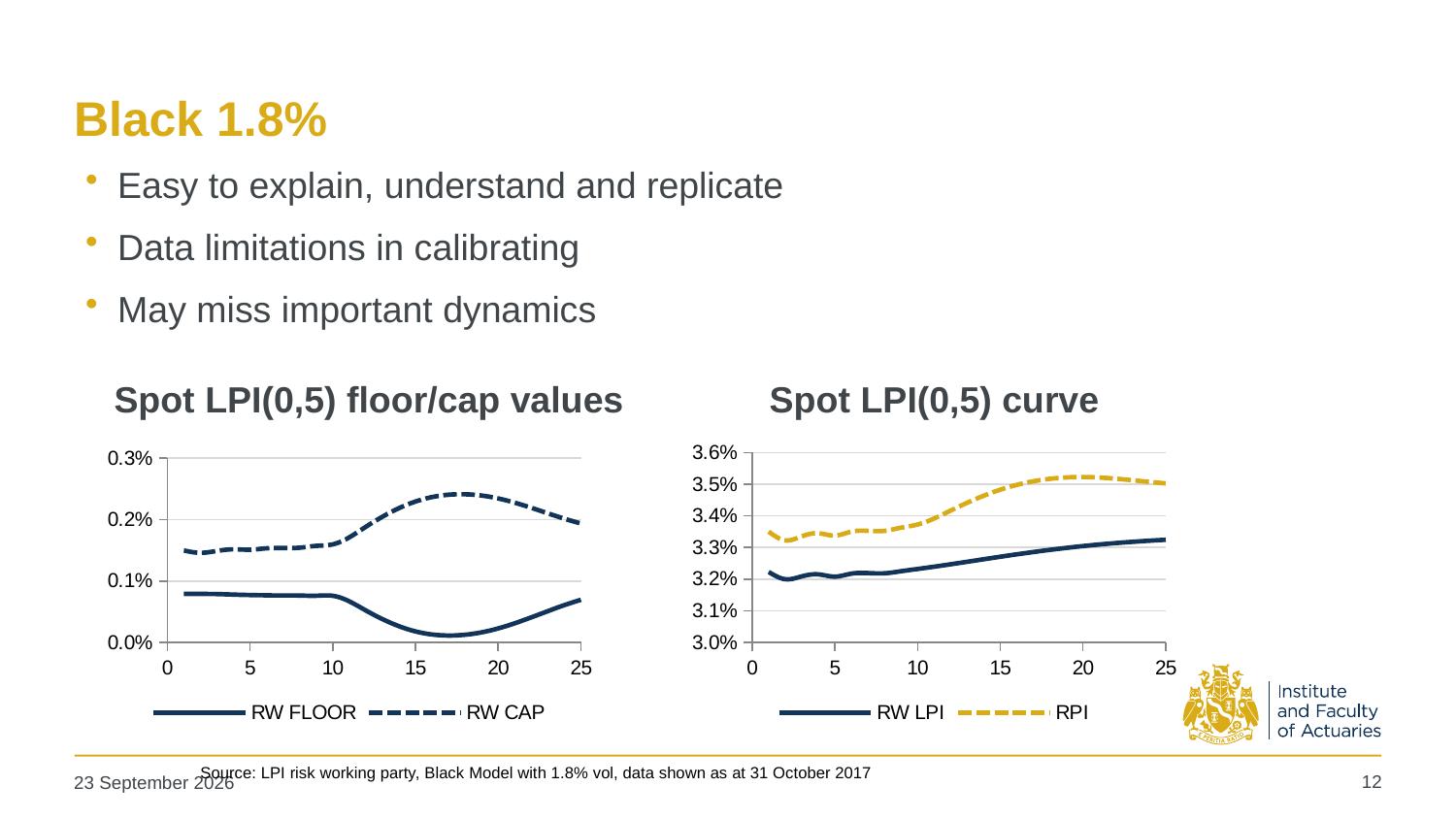
In the 'Spot LPI(0,5) curve' chart, what are the two series named in the legend? RW LPI and RPI In the 'Spot LPI(0,5) curve' chart, which series has the higher value at 10, RW LPI or RPI? RPI In the 'Spot LPI(0,5) floor/cap values' chart, is the RW CAP value at 18 greater or less than 0.2%? greater In the 'Spot LPI(0,5) floor/cap values' chart, is the RW FLOOR value at 5 greater or less than 0.1%? less What kind of chart is the 'Spot LPI(0,5) floor/cap values' chart? line chart In the 'Spot LPI(0,5) curve' chart, is the RPI value at 20 greater or less than 3.5%? greater In the 'Spot LPI(0,5) curve' chart, does the RW LPI series generally rise or fall from 5 to 25? rise In the 'Spot LPI(0,5) floor/cap values' chart, which series has the higher value at 15, RW FLOOR or RW CAP? RW CAP How many series does the legend of the 'Spot LPI(0,5) curve' chart list? 2 In the 'Spot LPI(0,5) floor/cap values' chart, which series is drawn with a dashed line? RW CAP